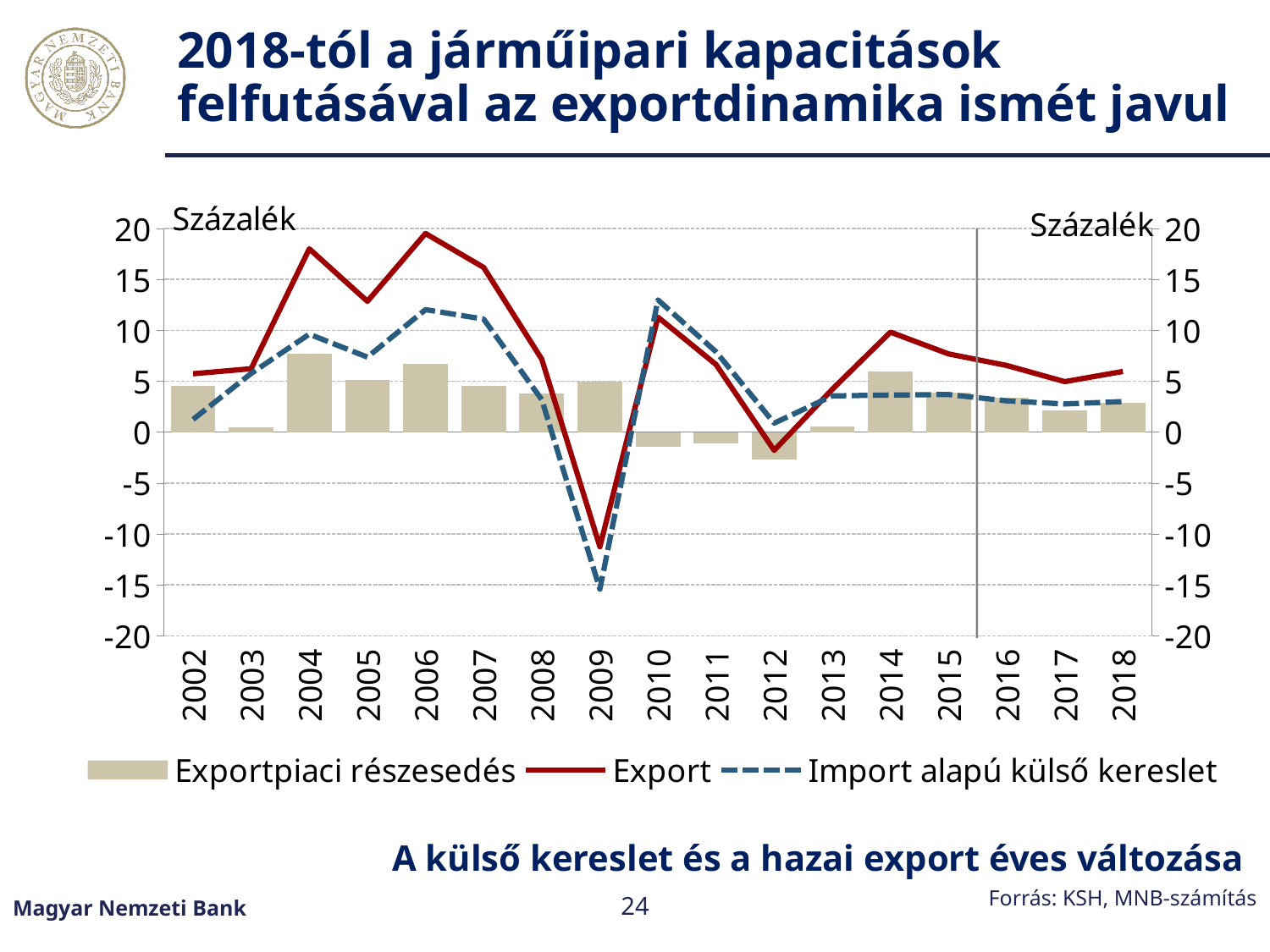
Is the Export value for 2006 greater or less than 15? greater Is the Exportpiaci részesedés bar for 2004 greater or less than 5? greater Does the Export line rise or fall from 2014 to 2017? fall In which year does the Import alapú külső kereslet line reach its lowest value? 2009 In which year does the Export line reach its highest value? 2006 What kind of chart is this? Combined bar and line chart Is the Import alapú külső kereslet value for 2009 greater or less than -10? less What is the title of the chart shown below the legend? A külső kereslet és a hazai export éves változása How many years are shown on the x axis? 17 Which is larger in 2010, the Export value or the Import alapú külső kereslet value? Import alapú külső kereslet In which year does the Export line reach its lowest value? 2009 How many series does the legend list? 3